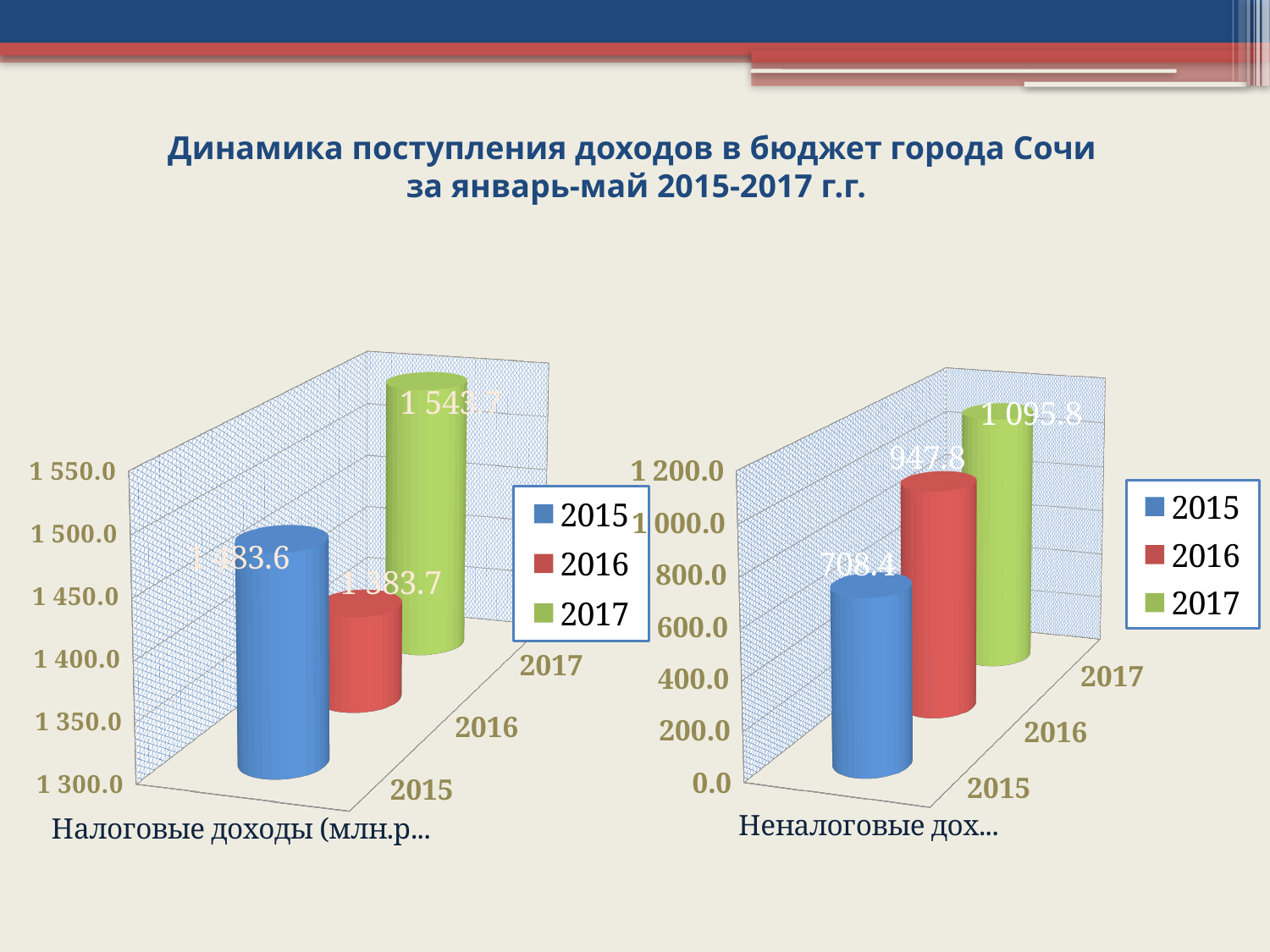
In the right chart (Неналоговые доходы), which year has the highest value? 2017 In the left chart (Налоговые доходы), what is the value for 2017? 1 543.7 How many entries does the legend of the left chart (Налоговые доходы) list? 3 In the right chart (Неналоговые доходы), what is the value for 2015? 708.4 In the left chart (Налоговые доходы), what is the value for 2016? 1 383.7 In the left chart (Налоговые доходы), which year has the lowest value? 2016 In the right chart (Неналоговые доходы), what is the value for 2017? 1 095.8 In the left chart (Налоговые доходы), which is larger, the value for 2015 or the value for 2016? 2015 In the right chart (Неналоговые доходы), what is the difference between the 2017 and 2015 values? 387.4 In the right chart (Неналоговые доходы), do the values rise or fall from 2015 to 2017? rise What type of chart is the left chart (Налоговые доходы)? bar chart How many bars are plotted in the right chart (Неналоговые доходы)? 3